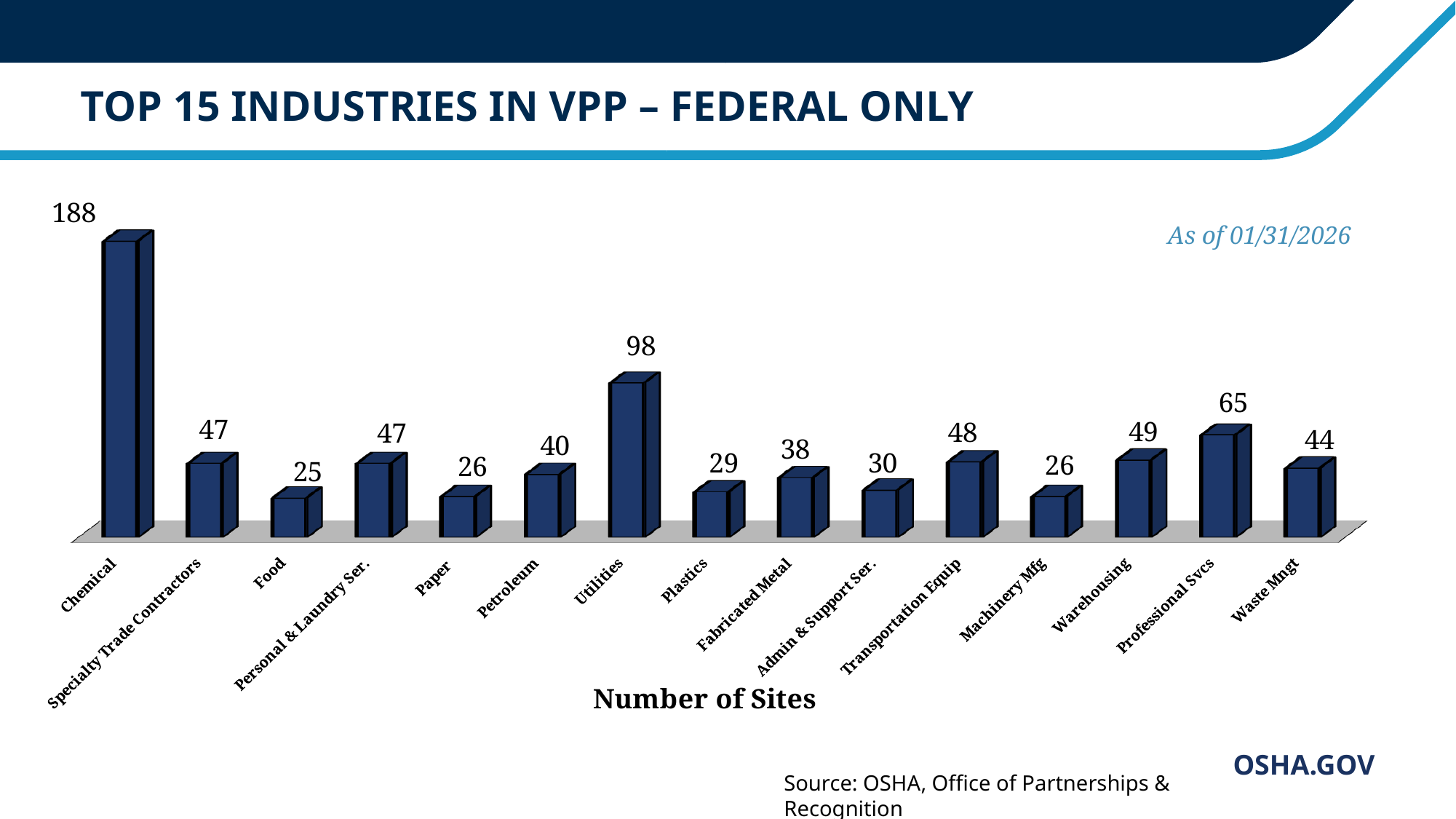
What kind of chart is shown on the slide? Bar chart What is the difference in number of sites between Chemical and Utilities? 90 What is the number of sites for Chemical? 188 What is the number of sites for Professional Svcs? 65 What is the number of sites for Utilities? 98 Which industry has the highest number of sites? Chemical What is the number of sites for Admin & Support Ser.? 30 Which has more sites, Petroleum or Fabricated Metal? Petroleum Which industry has the lowest number of sites? Food What is the title of the chart on the slide? TOP 15 INDUSTRIES IN VPP – FEDERAL ONLY How many industries are shown in the chart? 15 What is the difference in number of sites between Professional Svcs and Warehousing? 16